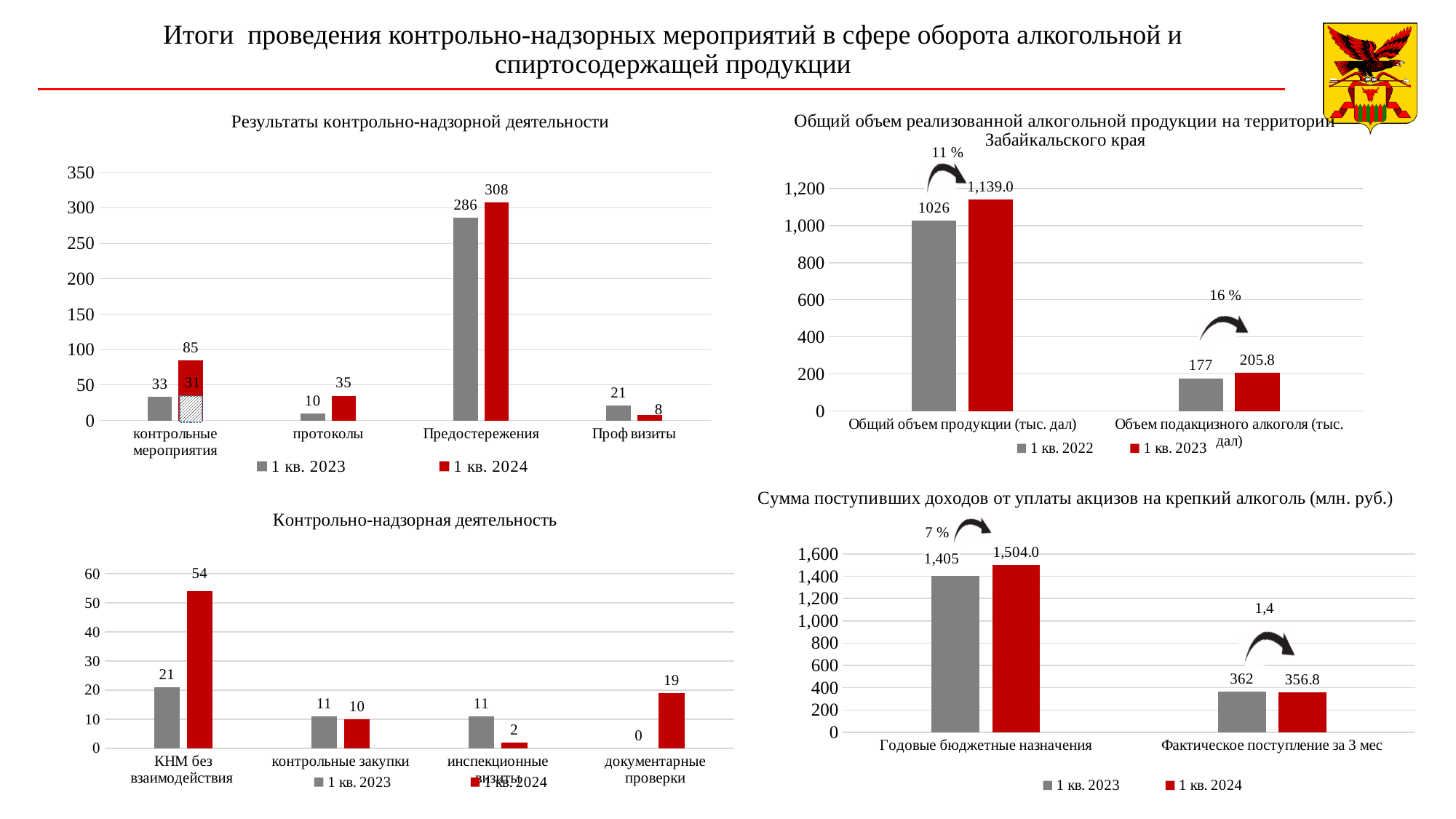
In the chart 'Контрольно-надзорная деятельность', which category has the lowest value for 1 кв. 2023? документарные проверки In the chart 'Общий объем реализованной алкогольной продукции на территории Забайкальского края', how many series does the legend list? 2 In the chart 'Результаты контрольно-надзорной деятельности', what is the value for Предостережения in 1 кв. 2024? 308 In the chart 'Результаты контрольно-надзорной деятельности', which category has the highest value for 1 кв. 2023? Предостережения In the chart 'Результаты контрольно-надзорной деятельности', how many categories are shown on the x axis? 4 In the chart 'Общий объем реализованной алкогольной продукции на территории Забайкальского края', what is the value for Объем подакцизного алкоголя (тыс. дал) in 1 кв. 2022? 177 In the chart 'Общий объем реализованной алкогольной продукции на территории Забайкальского края', what is the value for Общий объем продукции (тыс. дал) in 1 кв. 2023? 1,139.0 What kind of chart is 'Сумма поступивших доходов от уплаты акцизов на крепкий алкоголь (млн. руб.)'? bar chart In the chart 'Сумма поступивших доходов от уплаты акцизов на крепкий алкоголь (млн. руб.)', what is the value for Фактическое поступление за 3 мес in 1 кв. 2024? 356.8 In the chart 'Контрольно-надзорная деятельность', what is the value for КНМ без взаимодействия in 1 кв. 2024? 54 In the chart 'Результаты контрольно-надзорной деятельности', what is the difference between the 1 кв. 2024 and 1 кв. 2023 values for протоколы? 25 In the chart 'Контрольно-надзорная деятельность', which is larger for инспекционные визиты: 1 кв. 2023 or 1 кв. 2024? 1 кв. 2023